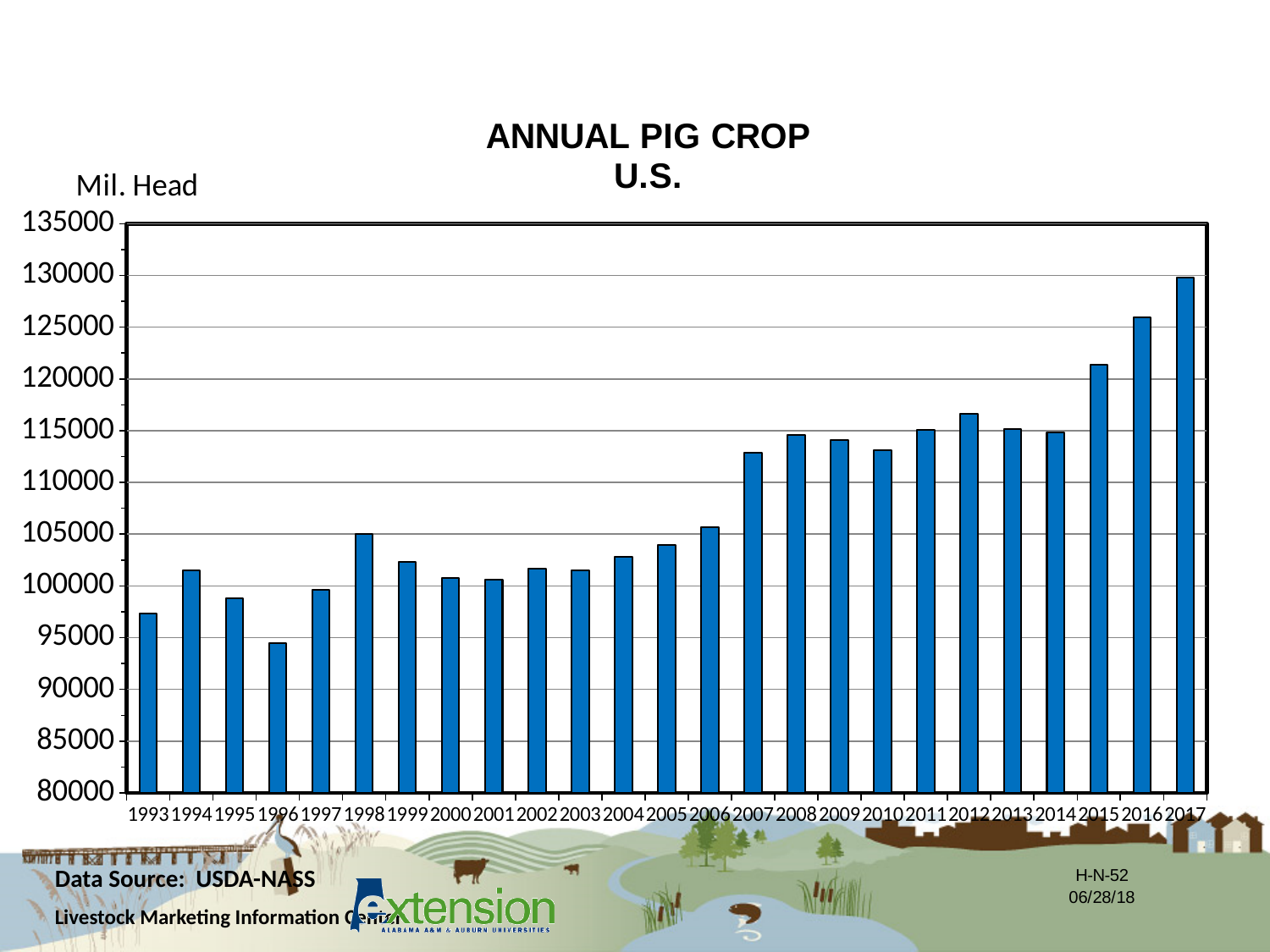
Which year has the highest annual pig crop? 2017 Is the value for 2015 greater or less than 120000? greater Which year has the larger annual pig crop, 1994 or 1995? 1994 Overall, do the values rise or fall from 1993 to 2017? rise Is the value for 2007 greater or less than 110000? greater What kind of chart is shown on the slide? bar chart Is the value for 1993 greater or less than 100000? less How many years are plotted on the chart? 25 What unit is shown on the vertical axis label? Mil. Head What is the title of the chart? ANNUAL PIG CROP U.S. Which year has the lowest annual pig crop? 1996